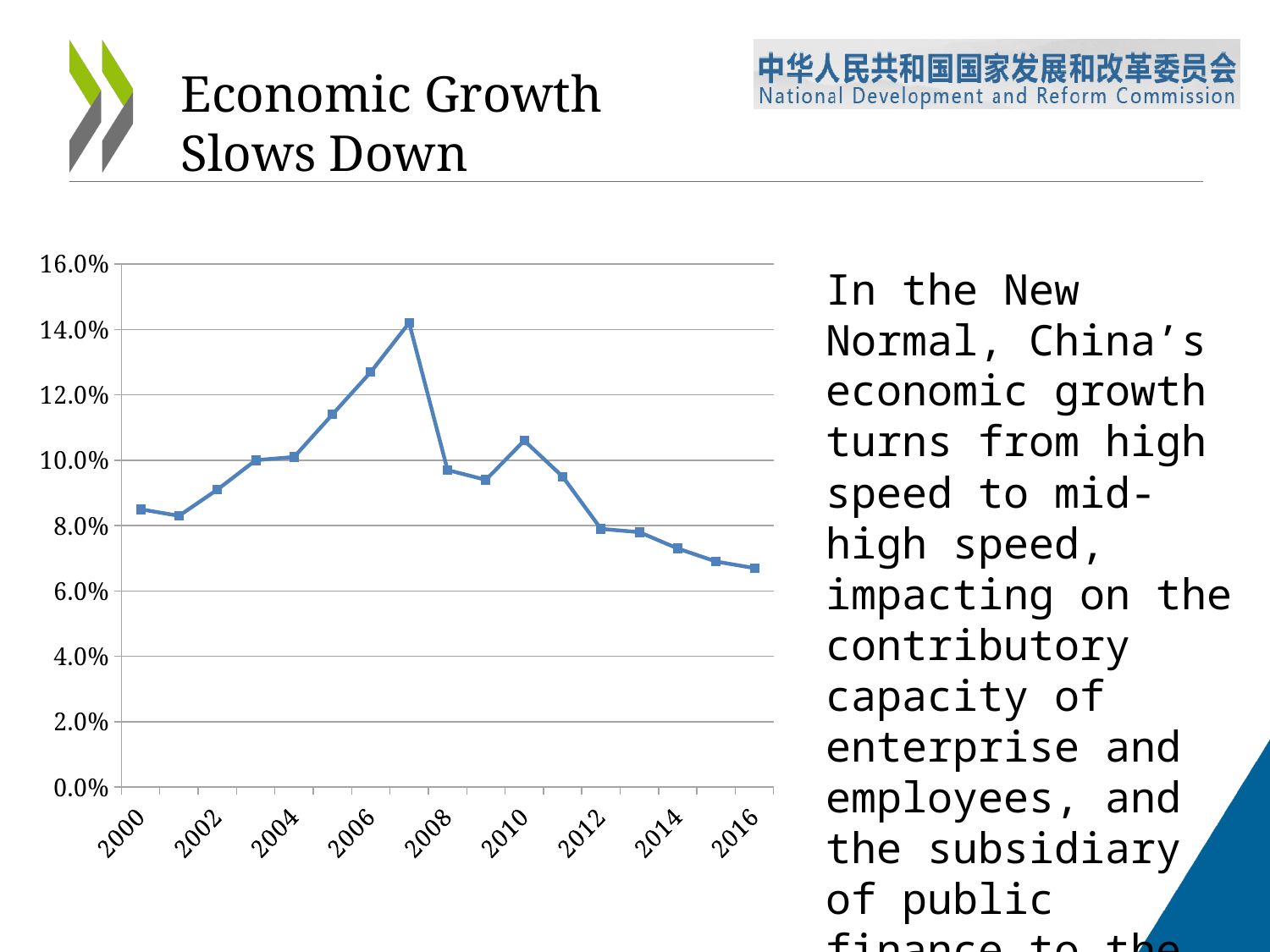
Is the value for 2016 greater or less than 8.0%? less How many data points are plotted on the line chart? 17 Is the value for 2006 greater or less than 12.0%? greater What is the highest value shown on the y axis? 16.0% Which year has a higher value, 2000 or 2016? 2000 Which year has a higher value, 2006 or 2010? 2006 Do the values rise or fall from 2010 to 2016? fall What kind of chart is shown on the slide? line chart Is the value for 2000 greater or less than 8.0%? greater Which labelled year on the x axis has the lowest value? 2016